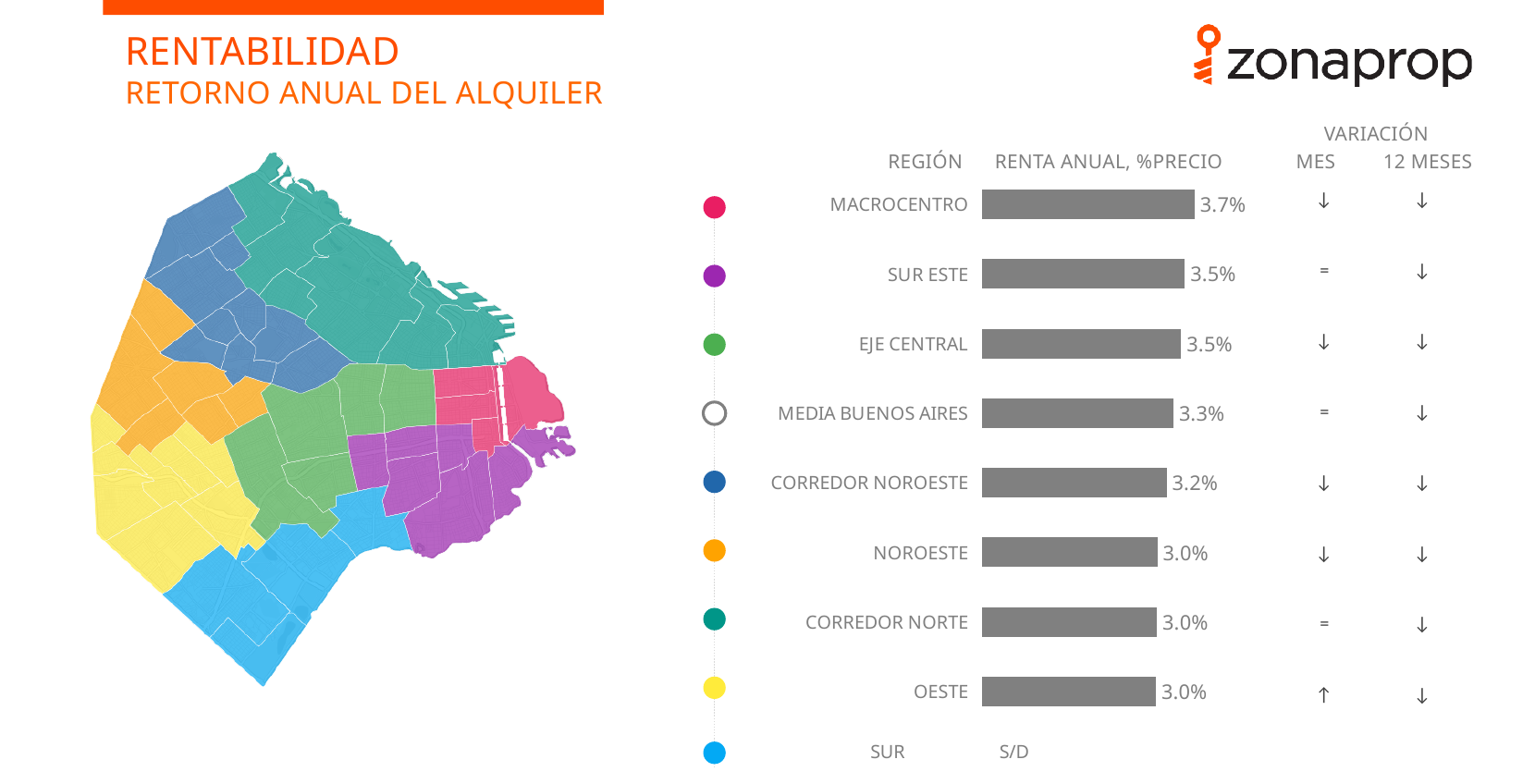
Do the annual rent return values increase or decrease going down the list of regions? Decrease What is the annual rent return (renta anual, %precio) for MACROCENTRO? 3.7% What kind of chart is used to show the annual rent return by region? Bar chart Which region shows an upward arrow in the monthly (MES) variation column? OESTE How many regions have a bar plotted in the chart? 8 What is the annual rent return shown for MEDIA BUENOS AIRES? 3.3% Which has a higher annual rent return, SUR ESTE or CORREDOR NORTE? SUR ESTE What is shown for the SUR region instead of a value? S/D What is the difference between the annual rent return of MACROCENTRO and NOROESTE? 0.7 percentage points What is the annual rent return shown for OESTE? 3.0% Which region has the highest annual rent return? MACROCENTRO What is the annual rent return shown for CORREDOR NOROESTE? 3.2%